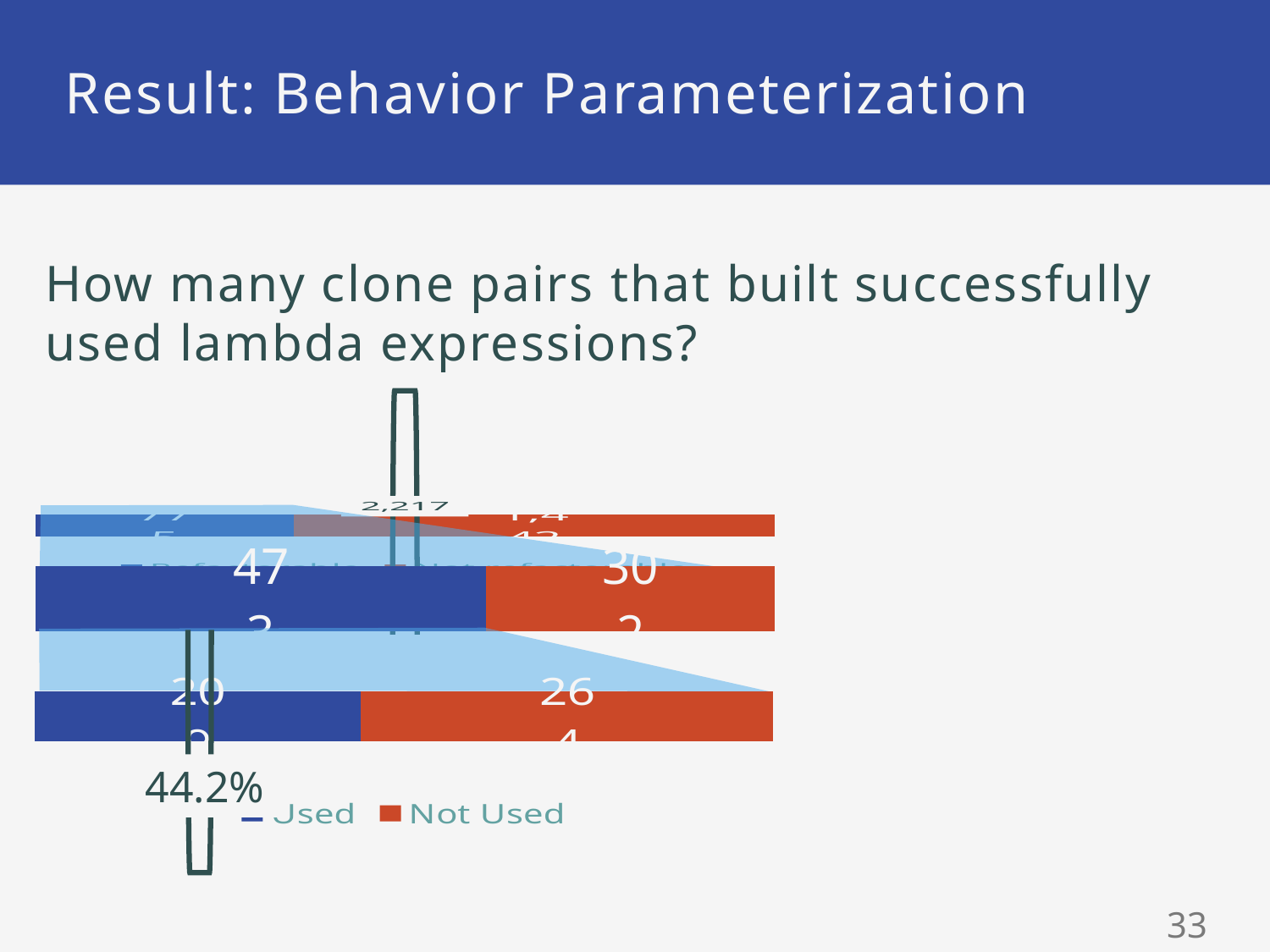
What are the two series names shown in the chart legend? Used, Not Used How many series does the chart legend list? 2 How many stacked bars are plotted in the chart? 3 What kind of chart is shown on the slide? bar chart Which colour represents the 'Not Used' series in the chart legend? red In the bottom bar of the chart, which segment is larger, Used or Not Used? Not Used